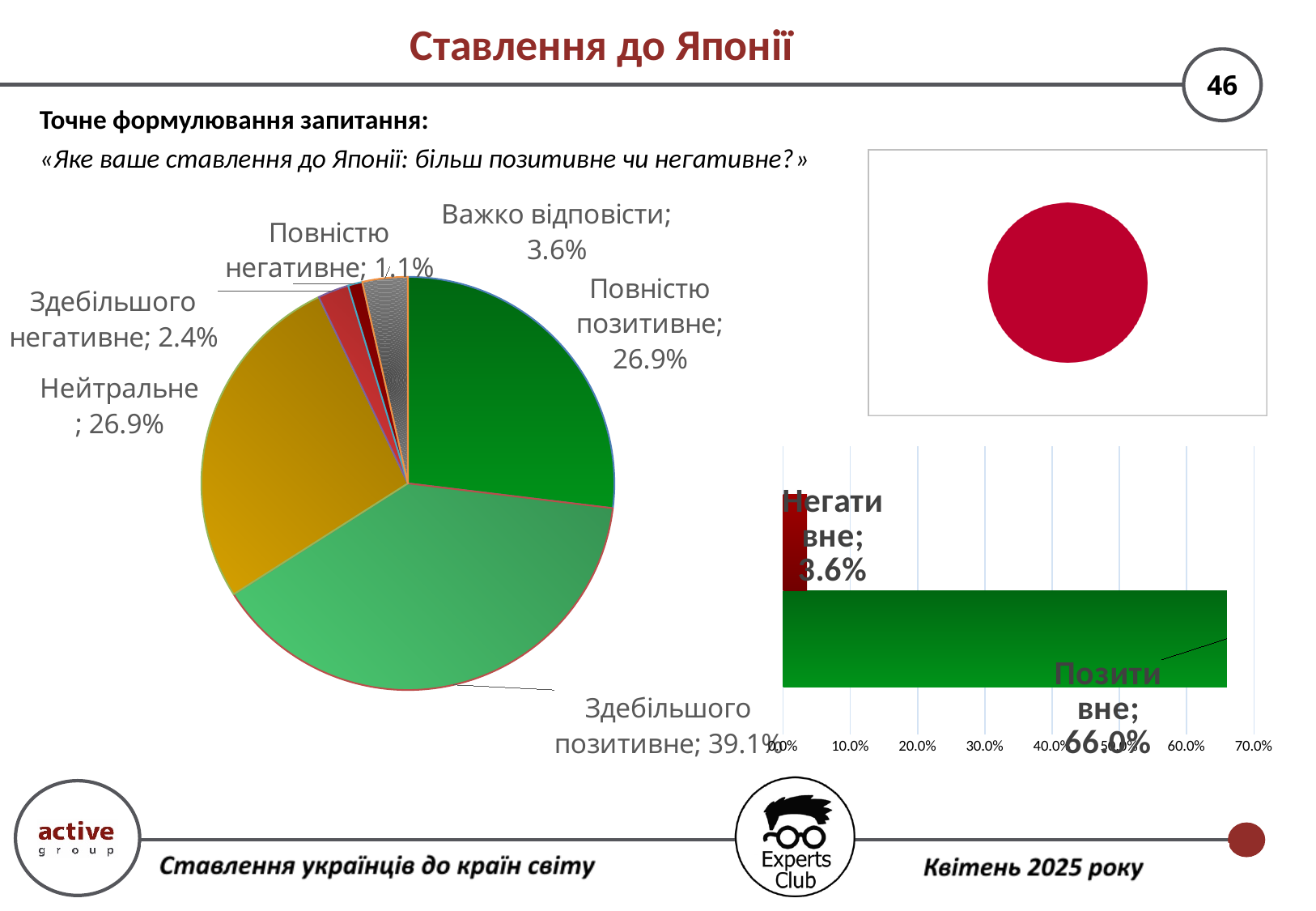
In the bar chart on the right, what is the value for «Негативне»? 3.6% In the pie chart, which is larger: the share for «Важко відповісти» or the share for «Здебільшого негативне»? Важко відповісти In the pie chart, how many answer categories are shown? 6 In the bar chart on the right, what is the difference between the values for «Позитивне» and «Негативне»? 62.4% In the pie chart, which answer category has the smallest share? Повністю негативне In the pie chart, what share of respondents answered «Повністю позитивне»? 26.9% In the pie chart, what share of respondents answered «Здебільшого негативне»? 2.4% In the pie chart, what is the difference between the shares for «Здебільшого позитивне» and «Нейтральне»? 12.2% In the bar chart on the right, what is the value for «Позитивне»? 66.0% In the pie chart, what share of respondents answered «Здебільшого позитивне»? 39.1% What type of chart is shown on the right side of the slide below the flag? Bar chart In the pie chart, which answer category has the largest share? Здебільшого позитивне